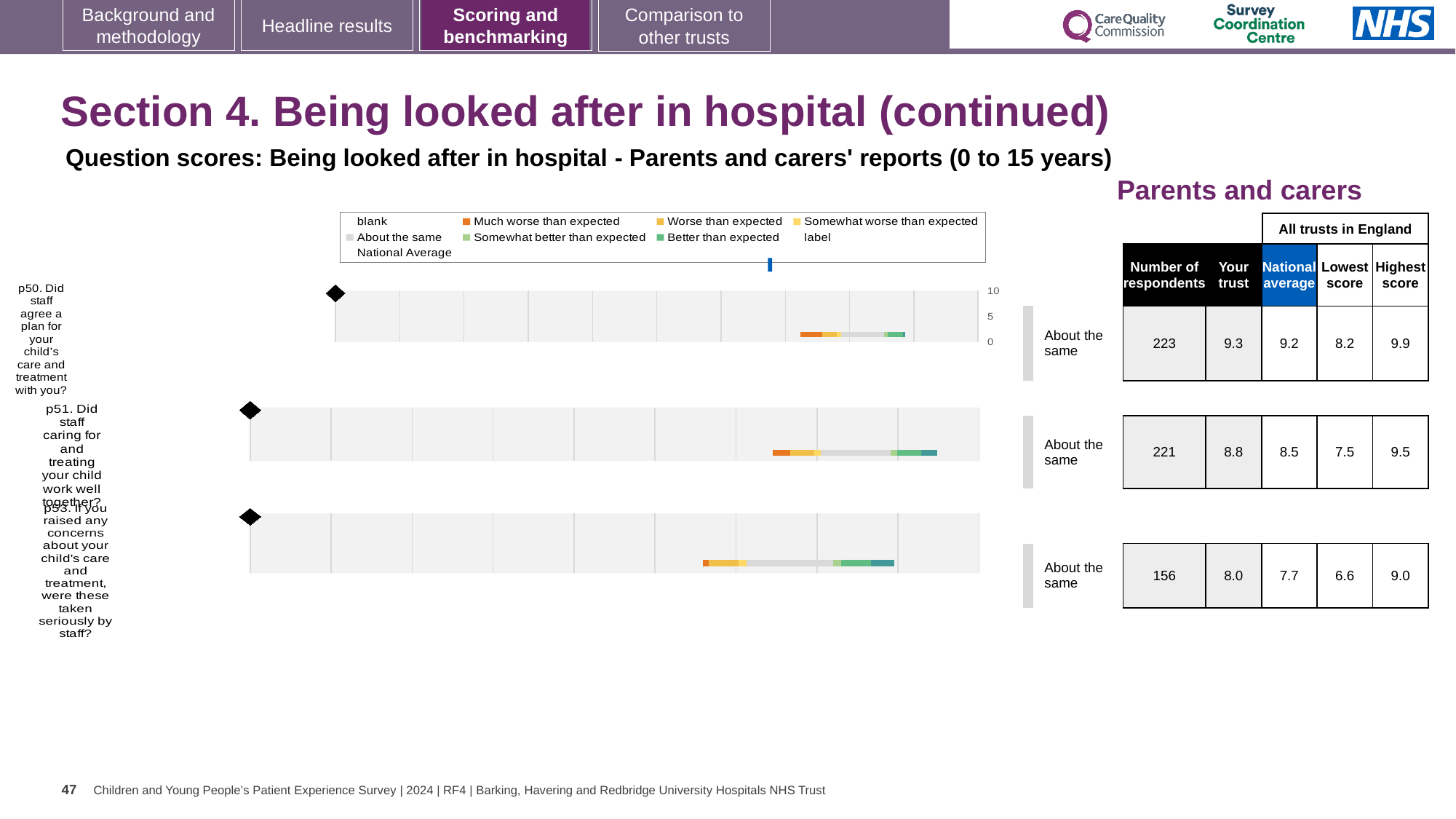
How many survey questions are charted on this slide? 3 For question p51, what is the difference between the 'Your trust' score and the national average? 0.3 What is the lowest score across all trusts in England for question p53? 6.6 Which of the three questions shown has the highest 'Your trust' score? p50 For question p53, what is the difference between the highest score and the lowest score across all trusts in England? 2.4 What is the national average score for question p51 (Did staff caring for and treating your child work well together?)? 8.5 What benchmark category is shown for question p51? About the same How many respondents are shown for question p53 (If you raised any concerns about your child's care and treatment, were these taken seriously by staff?)? 156 What is the highest score across all trusts in England for question p50? 9.9 What is the 'Your trust' score for question p50 (Did staff agree a plan for your child's care and treatment with you?)? 9.3 Which of the three questions shown has the lowest number of respondents? p53 For question p50, which is larger: the 'Your trust' score or the national average? Your trust (9.3)